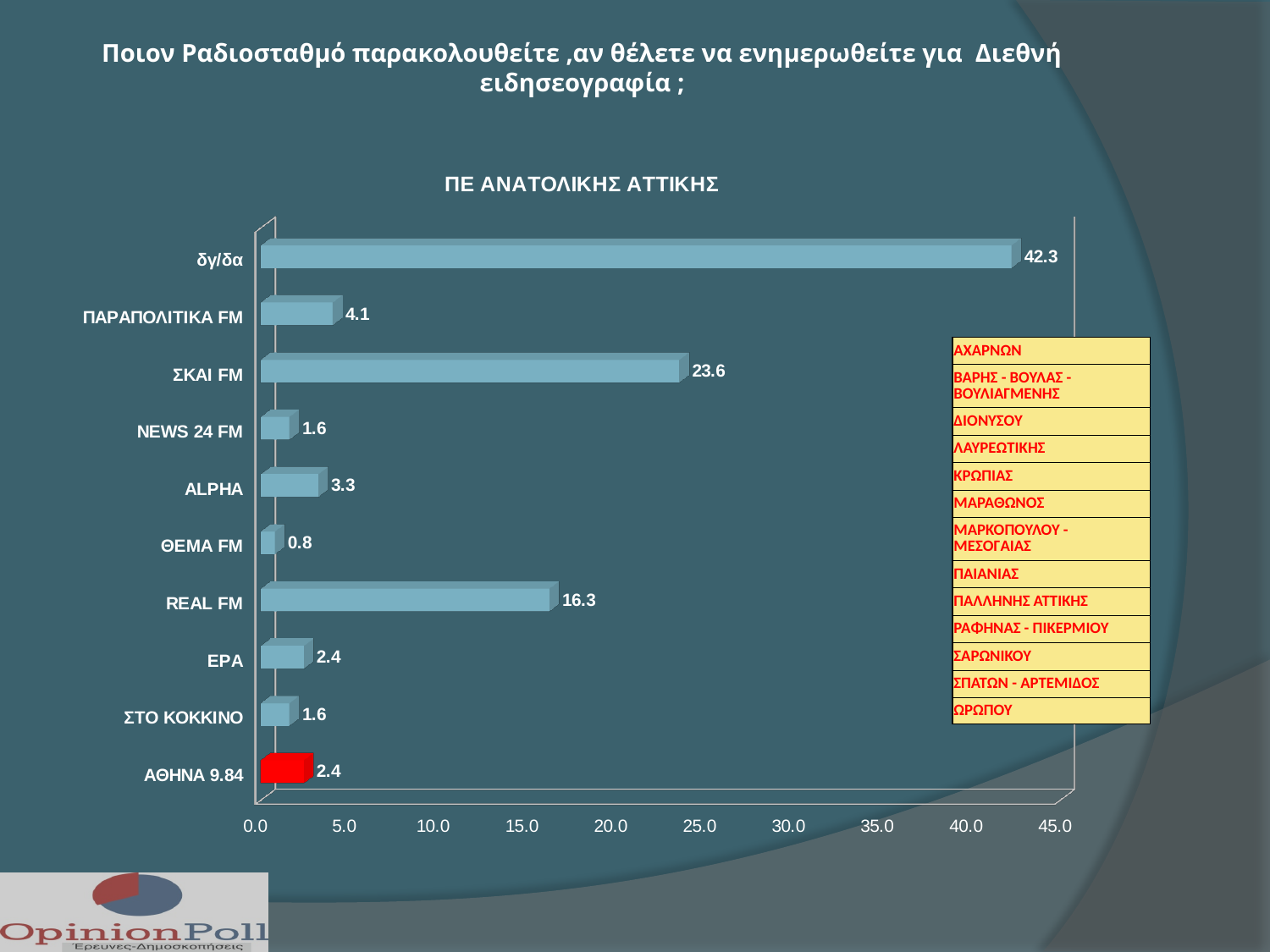
Which category has the highest value? δγ/δα What is the value for ΘΕΜΑ FM? 0.8 What is the value for ΣΚΑΙ FM? 23.6 What kind of chart is shown on the slide? bar chart How many categories are shown in the chart? 10 Which is larger, the value for ΠΑΡΑΠΟΛΙΤΙΚΑ FM or the value for ALPHA? ΠΑΡΑΠΟΛΙΤΙΚΑ FM What is the value for REAL FM? 16.3 What is the title of the chart? ΠΕ ΑΝΑΤΟΛΙΚΗΣ ΑΤΤΙΚΗΣ Which category has the lowest value? ΘΕΜΑ FM What is the difference between the values for ΣΚΑΙ FM and REAL FM? 7.3 Is the value for δγ/δα greater or less than 40.0? greater What is the value for ΑΘΗΝΑ 9.84? 2.4